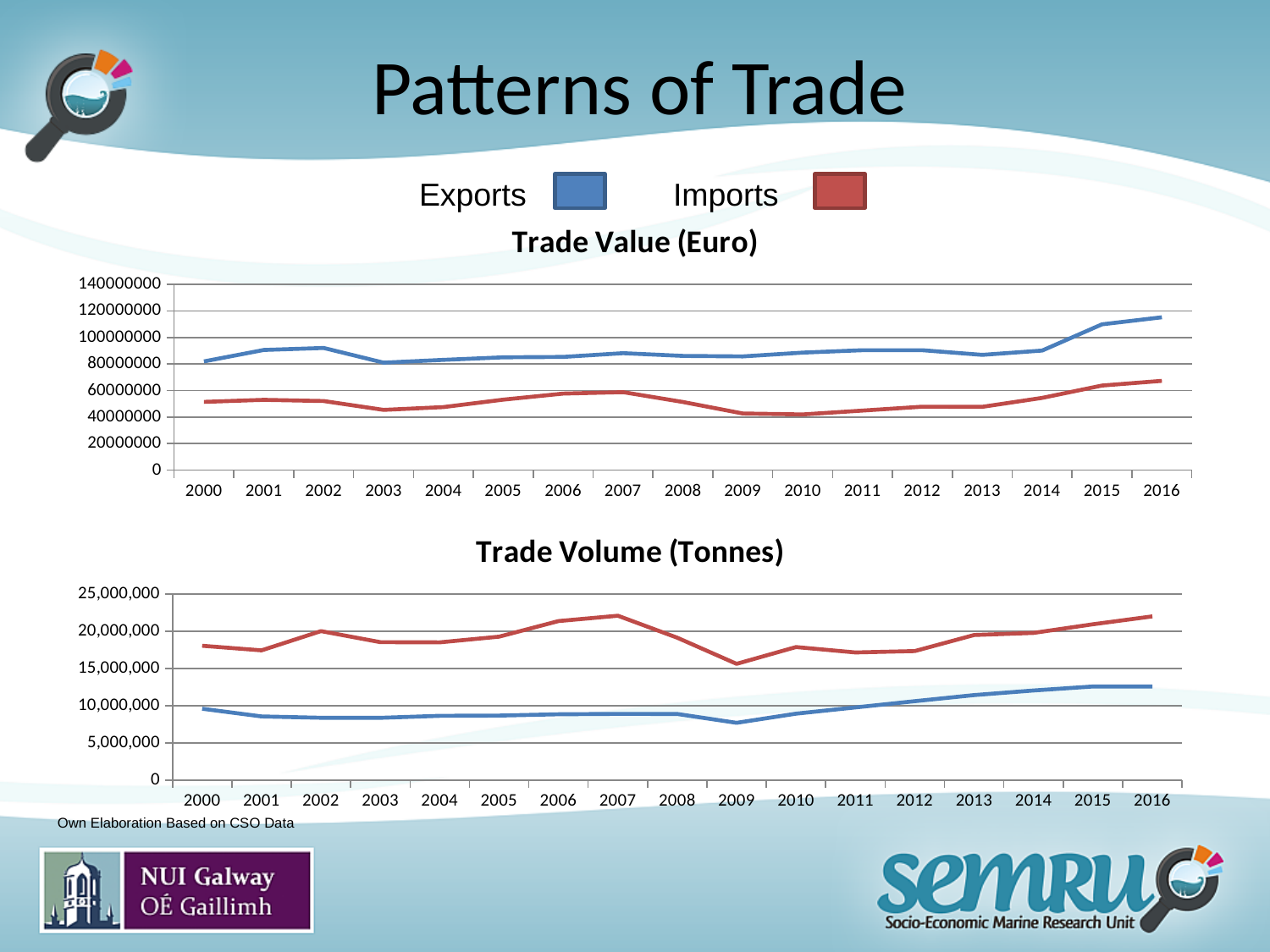
How many series does the legend list for the charts? 2 In the Trade Volume (Tonnes) chart, do Exports rise or fall from 2009 to 2016? rise How many years are plotted along the x axis of the Trade Volume (Tonnes) chart? 17 In the Trade Volume (Tonnes) chart, is the Imports value for 2007 greater or less than 20,000,000? greater Which colour represents Imports in the legend? red In the Trade Value (Euro) chart, is the Exports value for 2016 greater or less than 100000000? greater In the Trade Value (Euro) chart, which year has the highest Exports value? 2016 In the Trade Value (Euro) chart, is the Imports value for 2010 greater or less than 60000000? less In the Trade Volume (Tonnes) chart, which year has the lowest Exports value? 2009 What kind of chart is the Trade Value (Euro) chart? line chart In the Trade Value (Euro) chart, which is larger in 2008, Exports or Imports? Exports